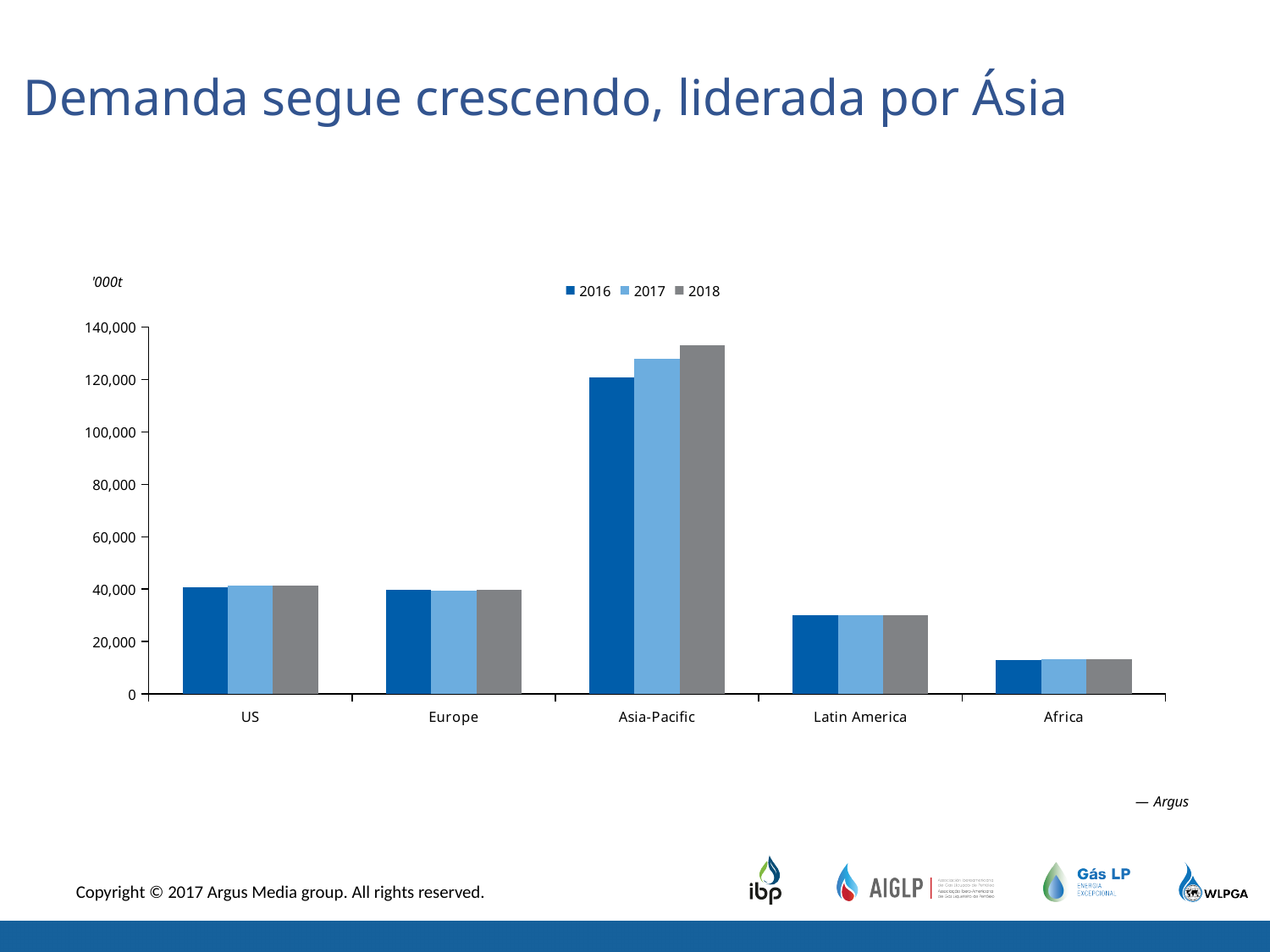
Is the 2016 value for Asia-Pacific greater or less than 100,000? greater Is the 2018 value for Latin America greater or less than 40,000? less What unit is shown at the top of the y axis? '000t Do the Asia-Pacific values rise or fall from 2016 to 2018? rise How many series does the legend list? 3 Which region has the lowest demand in 2016? Africa What kind of chart is shown on the slide? bar chart Which region has the highest demand in 2018? Asia-Pacific Which is larger in 2018, the value for Latin America or the value for Africa? Latin America How many regions are shown on the x axis? 5 Is the 2016 value for Africa greater or less than 20,000? less